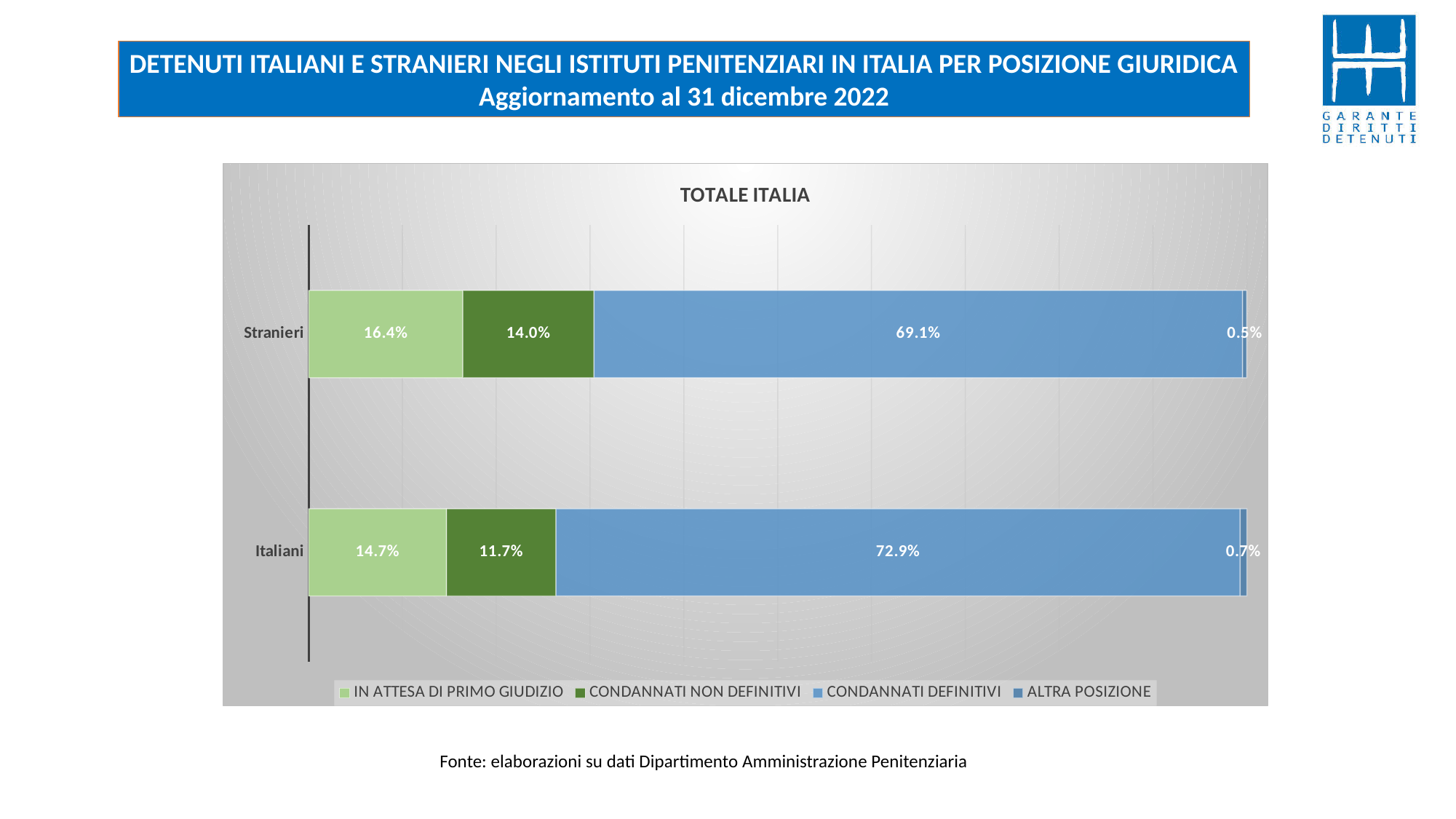
What is the value for IN ATTESA DI PRIMO GIUDIZIO for Stranieri? 16.4% Which is larger, the IN ATTESA DI PRIMO GIUDIZIO value for Stranieri or for Italiani? Stranieri Which series has the lowest value for Stranieri? ALTRA POSIZIONE How many categories are shown on the y axis? 2 What kind of chart is shown? Stacked bar chart How many series does the legend list? 4 What is the difference between the CONDANNATI DEFINITIVI values for Italiani and Stranieri? 3.8% Which series has the highest value for Italiani? CONDANNATI DEFINITIVI What is the value for CONDANNATI NON DEFINITIVI for Stranieri? 14.0% What is the value for ALTRA POSIZIONE for Italiani? 0.7% What is the title of the chart? TOTALE ITALIA What is the value for CONDANNATI DEFINITIVI for Italiani? 72.9%